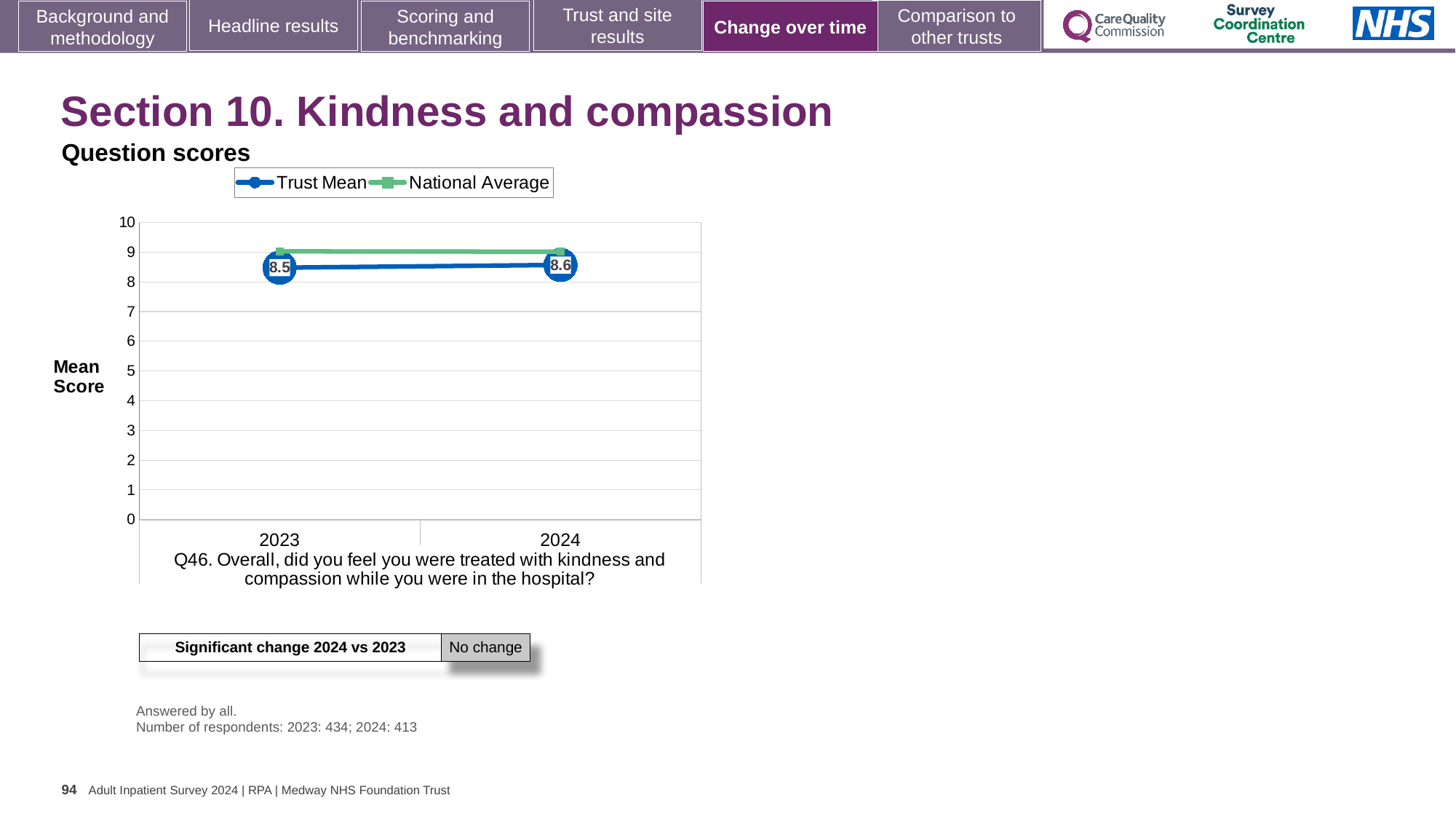
How many series does the legend list? 2 How many years are plotted on the x axis? 2 By how much did the Trust Mean change from 2023 to 2024? 0.1 Does the Trust Mean rise or fall from 2023 to 2024? rise Is the National Average value for 2023 greater or less than 8? greater What are the two series named in the legend? Trust Mean and National Average What kind of chart is shown on the slide? line chart What is the Trust Mean score for 2024? 8.6 What is the Trust Mean score for 2023? 8.5 What is the label on the y axis of the chart? Mean Score Which year has the higher Trust Mean score? 2024 In 2023, which is higher: the Trust Mean or the National Average? National Average